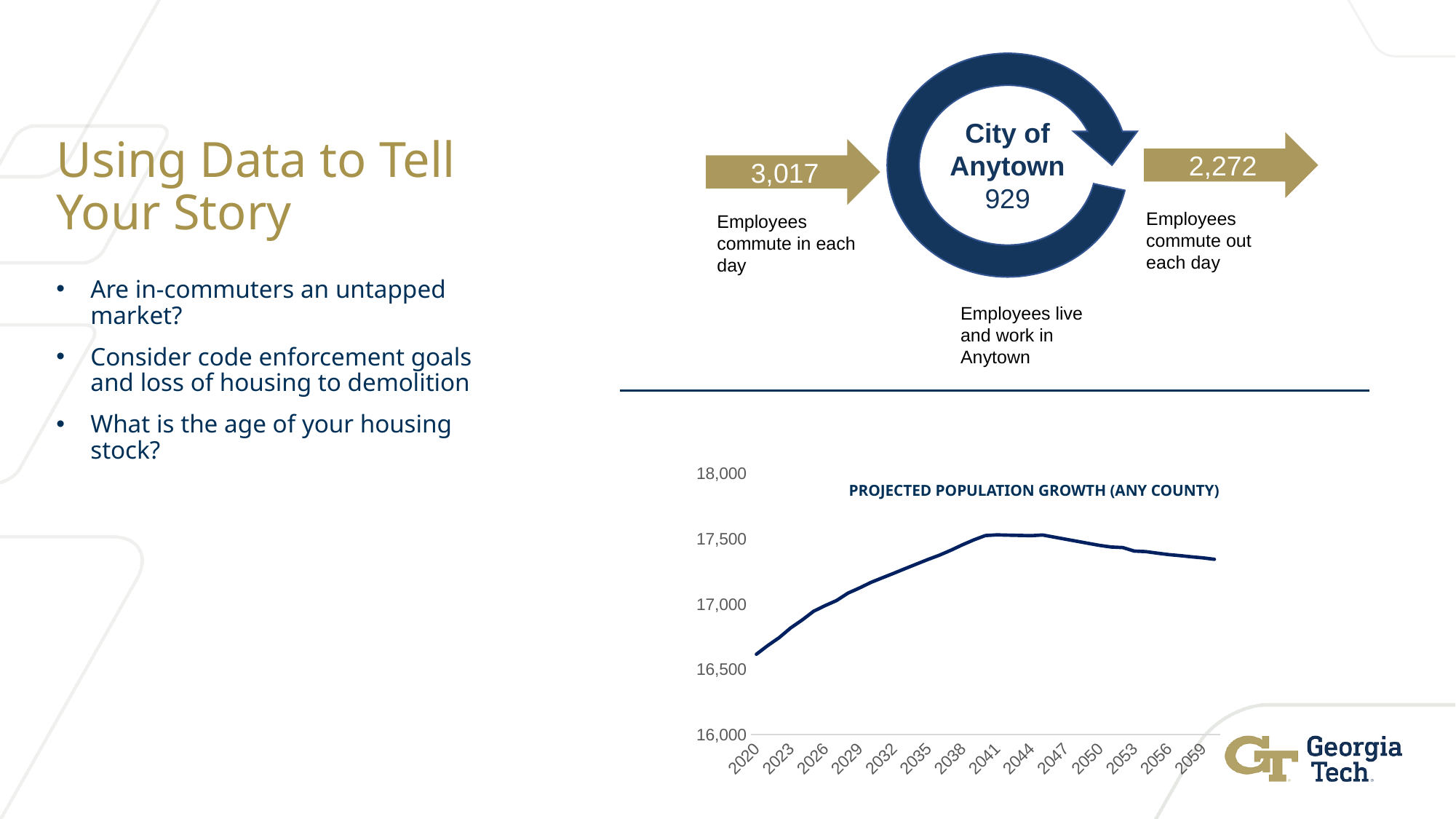
In the projected population growth chart, is the value for 2029 greater or less than 17,500? less In the projected population growth chart, is the value for 2020 greater or less than 16,500? greater In the projected population growth chart, is the value for 2059 greater or less than 17,500? less What is the title of the line chart? PROJECTED POPULATION GROWTH (ANY COUNTY) How many year labels are shown on the x axis of the projected population growth chart? 14 In the projected population growth chart, which year has a higher value, 2041 or 2059? 2041 What kind of chart is shown at the bottom right of the slide? line chart In the projected population growth chart, does the line rise or fall between 2044 and 2059? fall In the projected population growth chart, does the line rise or fall between 2020 and 2038? rise In the projected population growth chart, which year has a higher value, 2020 or 2059? 2059